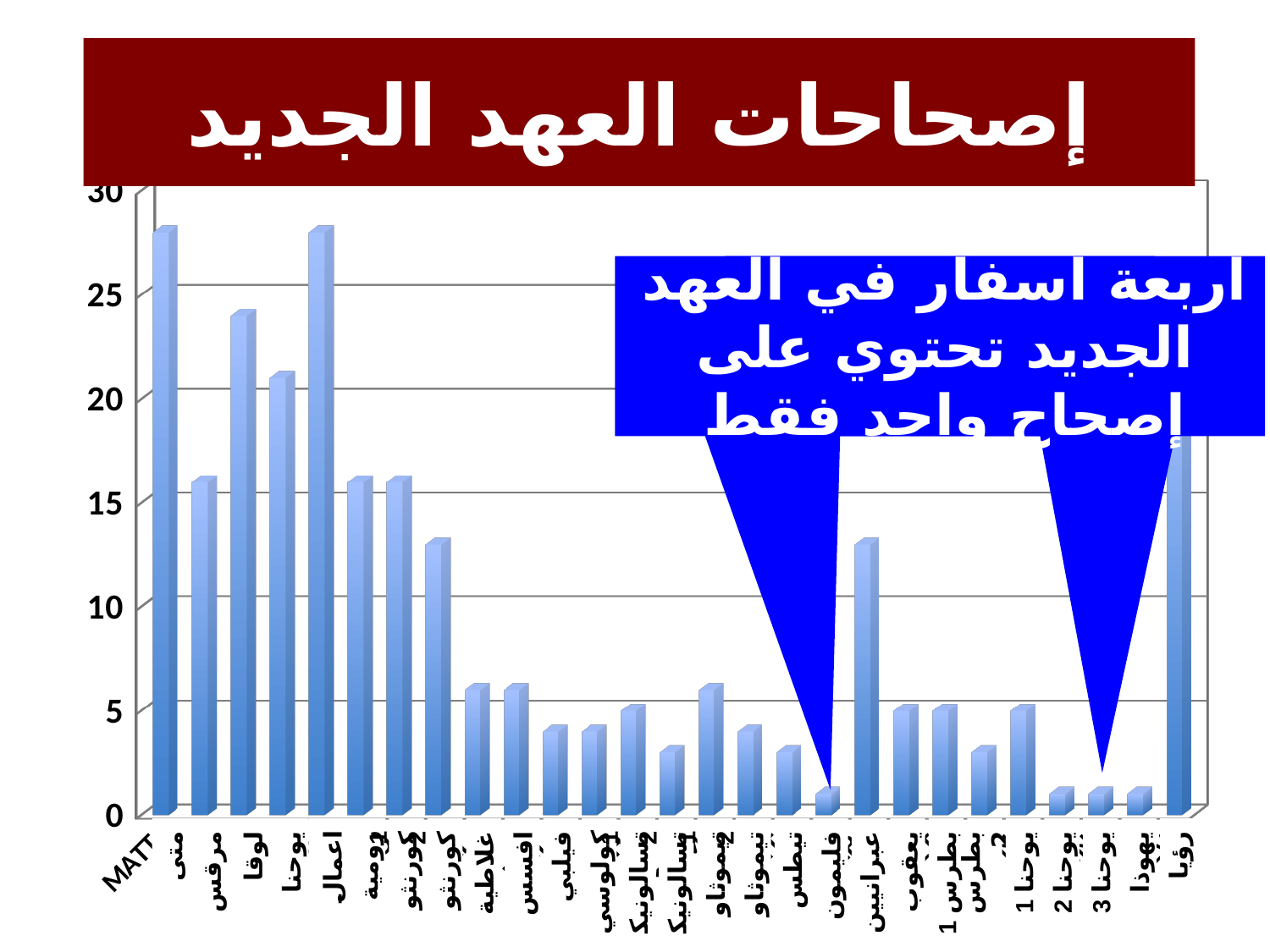
How many categories (bars) are plotted along the x axis? 27 Is the value for اعمال greater or less than 25? greater According to the blue callout on the chart, how many books of the New Testament contain only one chapter? اربعة (four) Is the value for تيطس greater or less than 5? less What kind of chart is shown on the slide? bar chart Which has the larger value, لوقا or مرقس? لوقا Which has the larger value, عبرانيين or يعقوب? عبرانيين Is the value for فليمون greater or less than 5? less What is the title of the chart on the slide? إصحاحات العهد الجديد